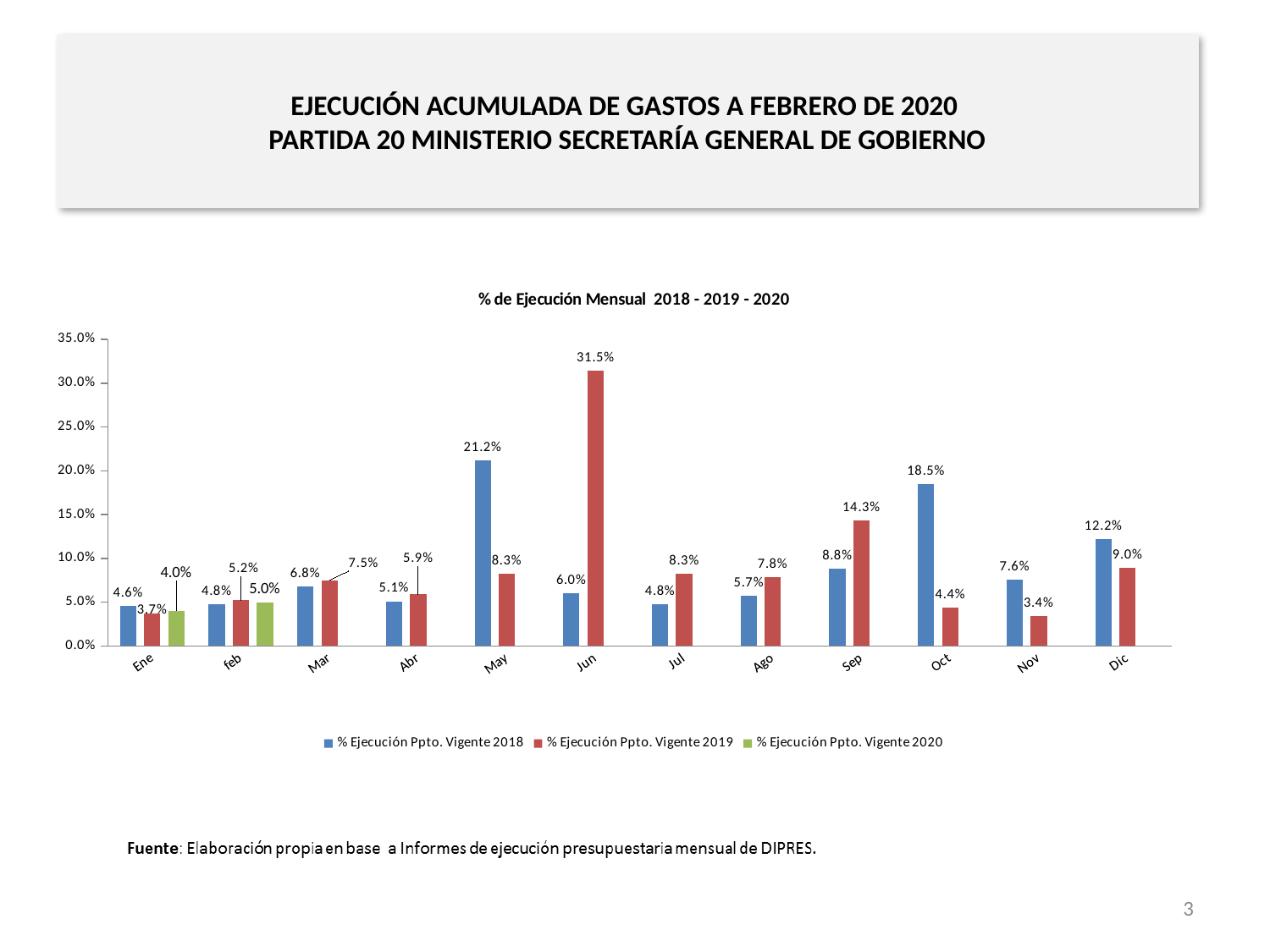
How many series does the legend list? 3 What is the value for % Ejecución Ppto. Vigente 2020 in feb? 5.0% Which month has the highest value for % Ejecución Ppto. Vigente 2018? May What is the value for % Ejecución Ppto. Vigente 2019 in Jun? 31.5% Which month has the lowest value for % Ejecución Ppto. Vigente 2019? Nov Is the value for % Ejecución Ppto. Vigente 2019 in Jun greater or less than 30.0%? greater Which is larger in Sep: the 2018 value or the 2019 value? 2019 value (14.3%) What is the difference between the 2018 and 2019 values in Oct? 14.1% How many months are shown on the x axis? 12 What is the title of the chart? % de Ejecución Mensual 2018 - 2019 - 2020 What is the value for % Ejecución Ppto. Vigente 2018 in May? 21.2% What kind of chart is shown on the slide? Bar chart